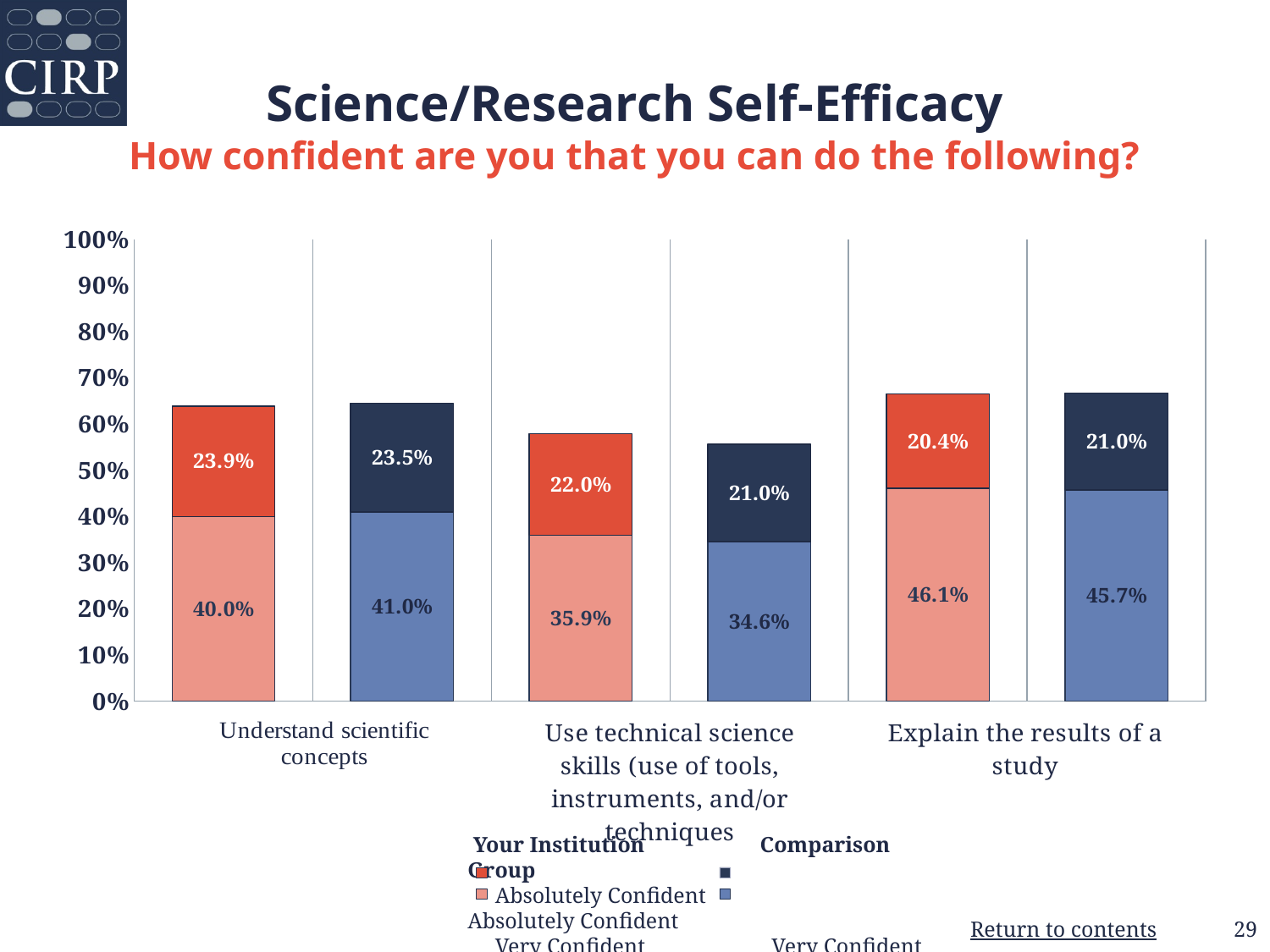
For the Your Institution bars, which category has the smallest top segment? Explain the results of a study What is the total height of the Your Institution stacked bar for 'Understand scientific concepts'? 63.9% Is the total height of the Your Institution bar for 'Explain the results of a study' greater or less than 60%? greater What is the total height of the Comparison Group stacked bar for 'Use technical science skills'? 55.6% What kind of chart is shown on the slide? Stacked bar chart What is the value of the bottom (light blue) segment of the Comparison Group bar for 'Use technical science skills'? 34.6% How many question categories are shown along the x axis of the chart? 3 What is the value of the top (dark navy) segment of the Comparison Group bar for 'Explain the results of a study'? 21.0% For 'Use technical science skills', which has the larger bottom segment: Your Institution or Comparison Group? Your Institution What is the value of the bottom (light red) segment of the Your Institution bar for 'Understand scientific concepts'? 40.0% For the Your Institution bars, which category has the largest bottom segment? Explain the results of a study What is the difference between the bottom segments of the Your Institution bar (46.1%) and the Comparison Group bar (45.7%) for 'Explain the results of a study'? 0.4 percentage points